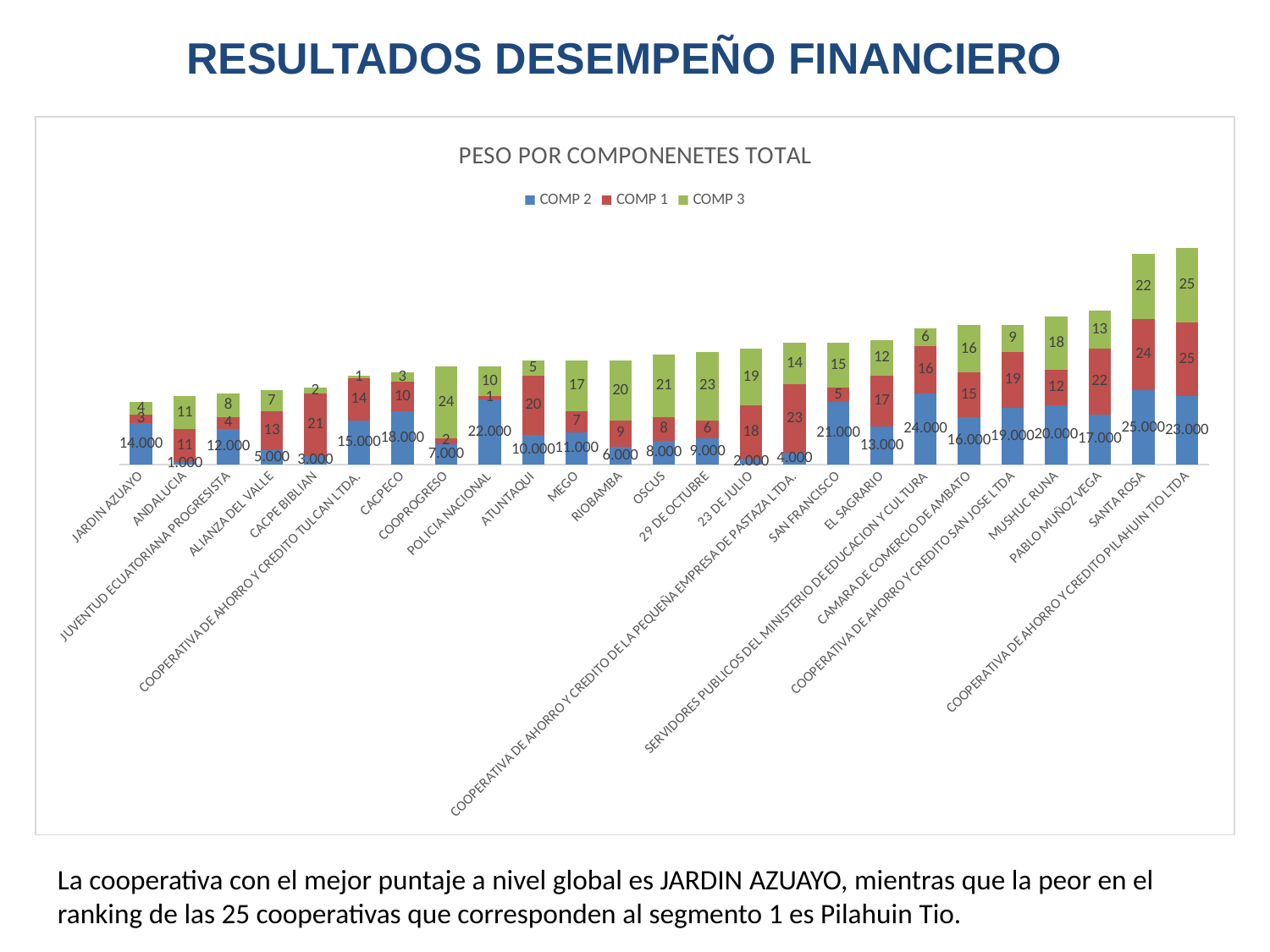
Which is larger, the COMP 3 value for 29 DE OCTUBRE or for ATUNTAQUI? 29 DE OCTUBRE How many cooperatives (categories) are plotted on the x axis of the chart? 25 What is the COMP 2 value for SANTA ROSA? 25.000 How many series does the legend of the chart list? 3 What kind of chart is shown on the slide? Stacked bar chart What is the COMP 1 value for CACPE BIBLIAN? 21 What is the total of the stacked bar for MUSHUC RUNA? 50 What is the total of the stacked bar for JARDIN AZUAYO? 21 Which cooperative has the highest COMP 1 value? COOPERATIVA DE AHORRO Y CREDITO PILAHUIN TIO LTDA What is the difference between the COMP 1 value for ATUNTAQUI and the COMP 1 value for MEGO? 13 What is the COMP 3 value for COOPROGRESO? 24 What is the title of the chart? PESO POR COMPONENETES TOTAL